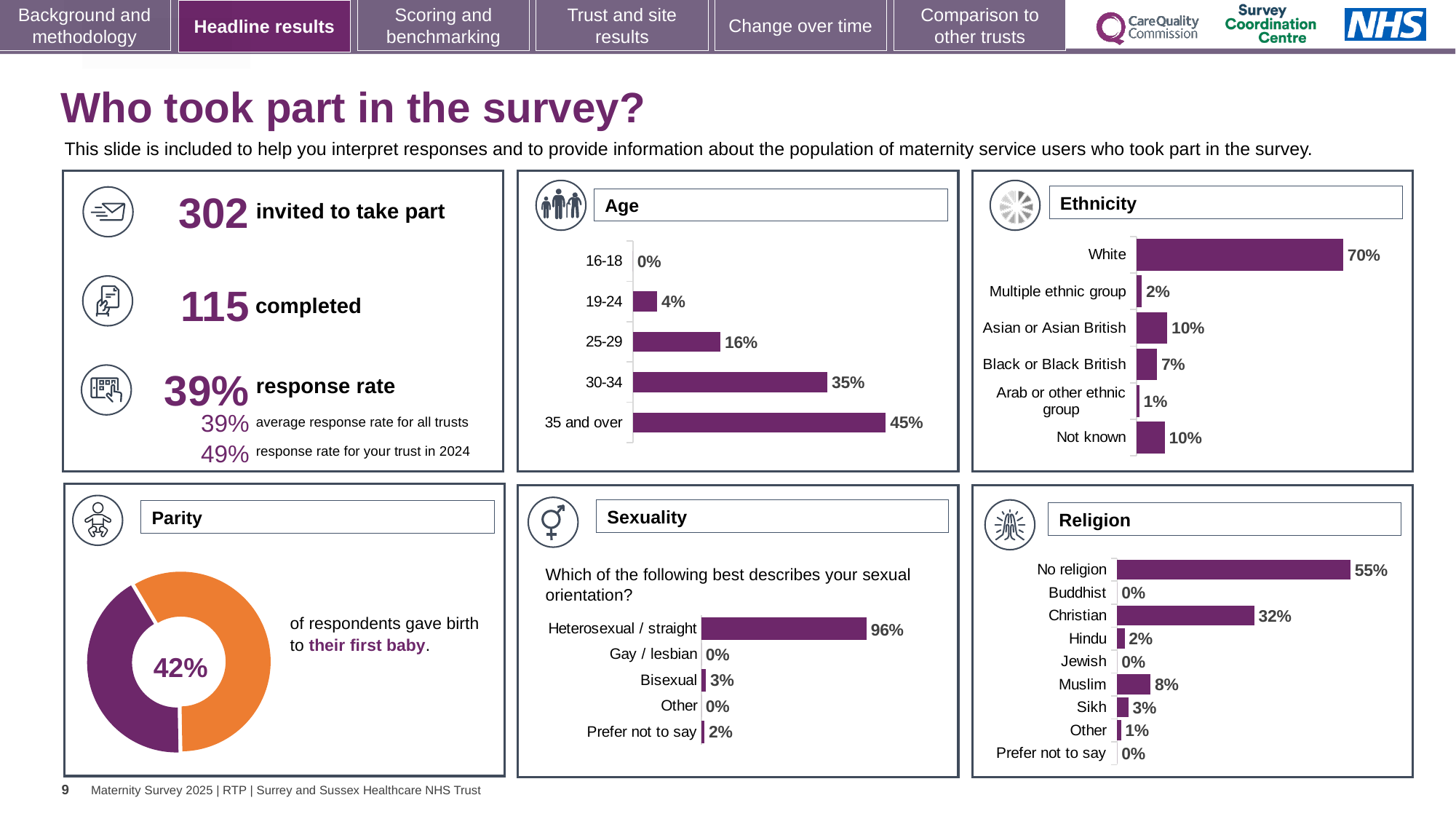
In the Religion chart, what is the difference between No religion and Christian? 23% In the Sexuality chart, what percentage of respondents answered Heterosexual / straight? 96% In the Parity chart, what share of respondents gave birth to their first baby? 42% In the Age chart, what percentage of respondents were aged 35 and over? 45% In the Age chart, which age group has the highest percentage? 35 and over In the Ethnicity chart, which category has the lowest percentage? Arab or other ethnic group In the Ethnicity chart, how many categories are shown? 6 What kind of chart is the Parity chart? Pie chart (doughnut) In the Age chart, what is the difference between the 30-34 and 25-29 percentages? 19% In the Religion chart, which is larger, Muslim or Sikh? Muslim In the Ethnicity chart, what percentage of respondents were White? 70% In the Religion chart, what percentage of respondents were Christian? 32%